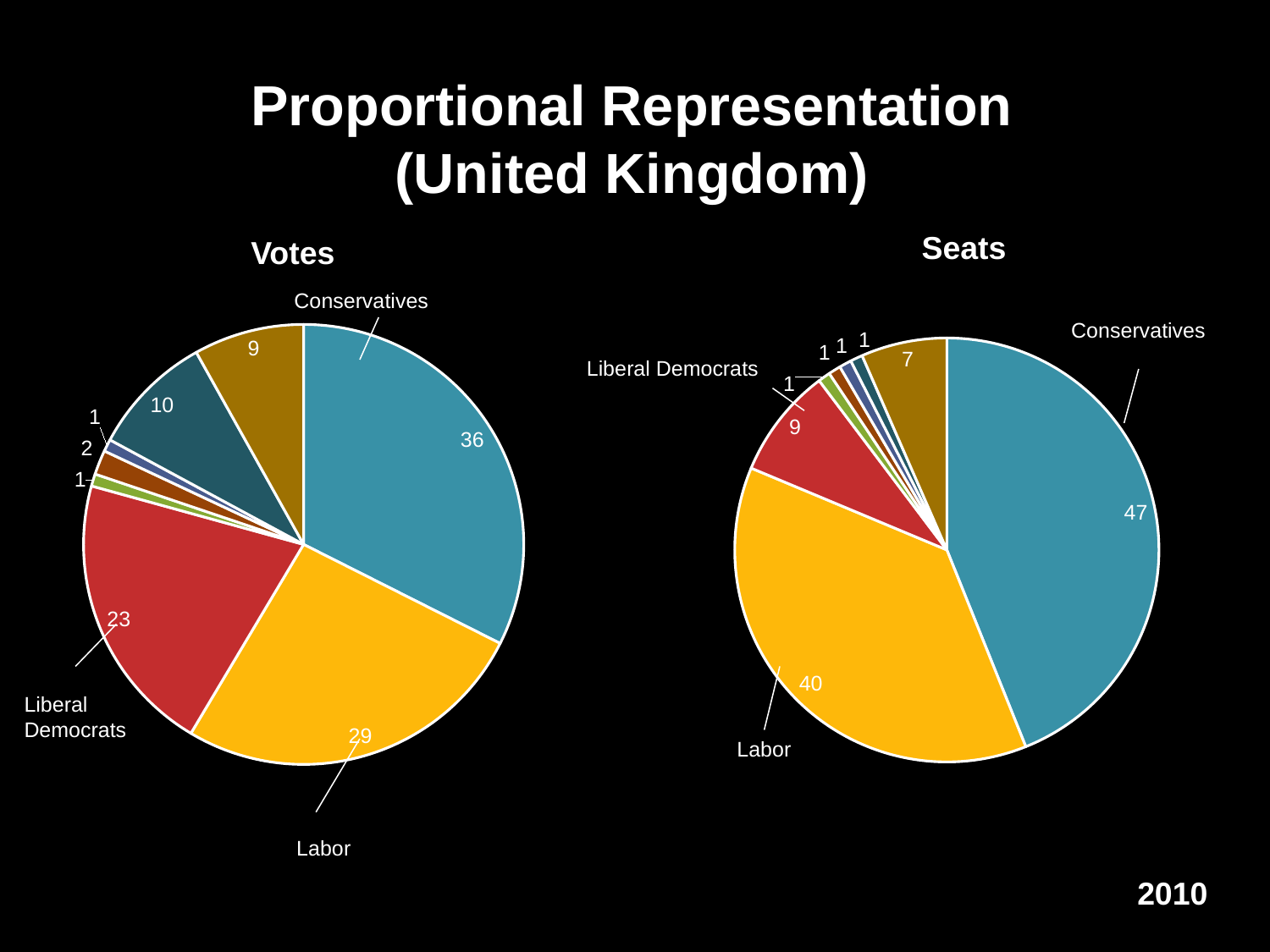
In the Seats pie chart, what is the value for Liberal Democrats? 9 In the Seats pie chart, which party has the largest slice? Conservatives In the Seats pie chart, what is the value for Labor? 40 What kind of chart is used for the Votes and Seats data on this slide? Pie chart Which is larger: the Liberal Democrats value in the Votes chart or the Liberal Democrats value in the Seats chart? Votes In the Votes pie chart, what is the value for Liberal Democrats? 23 In the Votes pie chart, what is the value for Conservatives? 36 In the Votes pie chart, what is the difference between the Labor value and the Liberal Democrats value? 6 In the Seats pie chart, what is the difference between the Conservatives value and the Labor value? 7 In the Votes pie chart, which party has the largest slice? Conservatives In the Votes pie chart, what is the value for Labor? 29 In the Seats pie chart, what is the value for Conservatives? 47